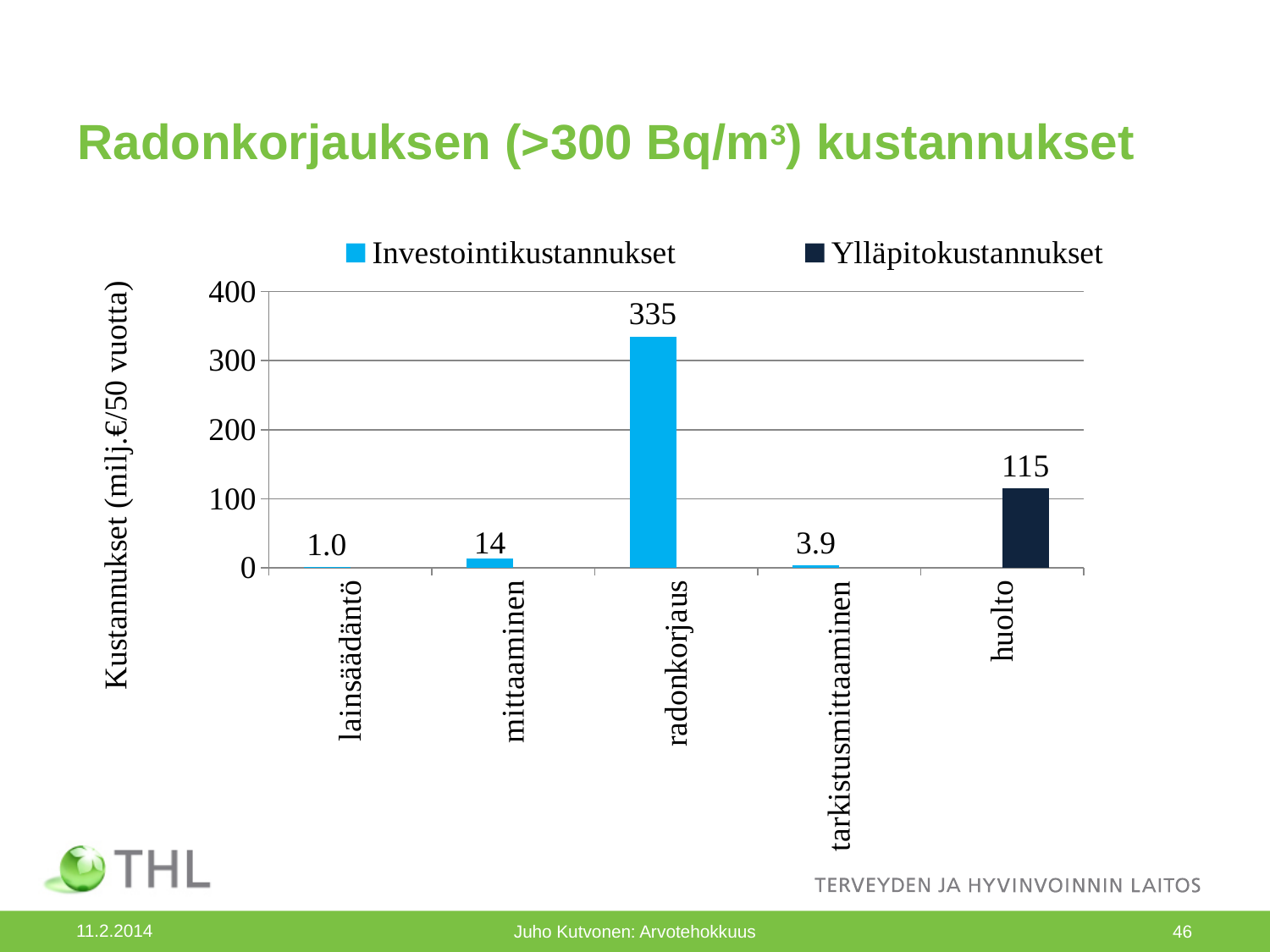
What kind of chart is shown on the slide? bar chart What is the value for huolto? 115 What is the value for tarkistusmittaaminen? 3.9 Which is larger, the value for mittaaminen or the value for tarkistusmittaaminen? mittaaminen Which category has the highest value? radonkorjaus How many categories are shown on the x axis? 5 Which category has the lowest value? lainsäädäntö What is the difference between the values for radonkorjaus and huolto? 220 What is the value for radonkorjaus? 335 How many series does the legend list? 2 Which series does the huolto bar belong to? Ylläpitokustannukset What is the value for mittaaminen? 14